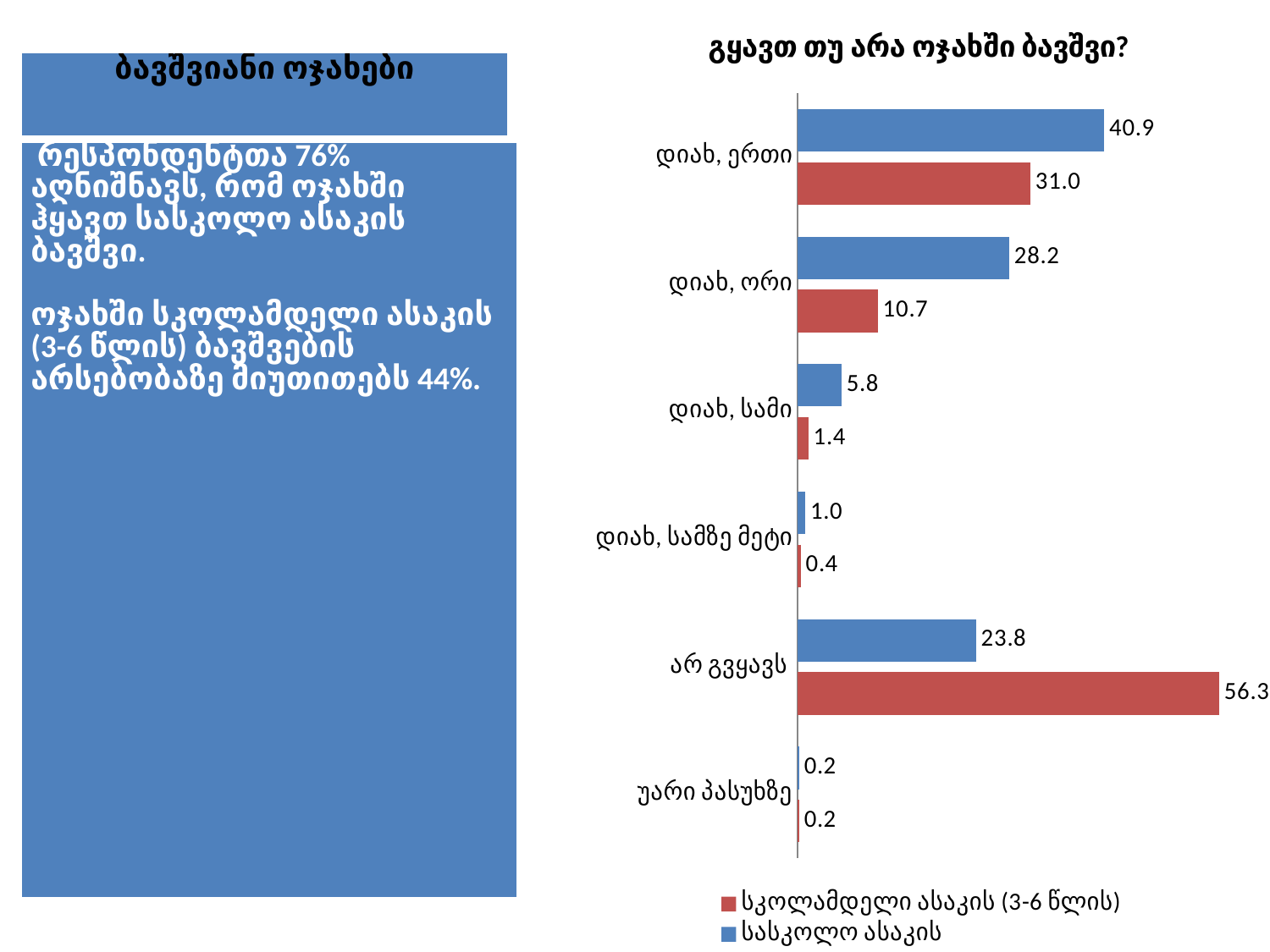
How many categories are shown on the chart? 6 What kind of chart is shown on the slide? bar chart What is the difference between the სასკოლო ასაკის and სკოლამდელი ასაკის (3-6 წლის) values in the category დიახ, ერთი? 9.9 How many series does the legend list? 2 What is the value for სკოლამდელი ასაკის (3-6 წლის) in the category დიახ, ორი? 10.7 What is the value for სკოლამდელი ასაკის (3-6 წლის) in the category არ გვყავს? 56.3 Which category has the highest value for the სასკოლო ასაკის series? დიახ, ერთი In the category არ გვყავს, which series has the larger value: სასკოლო ასაკის or სკოლამდელი ასაკის (3-6 წლის)? სკოლამდელი ასაკის (3-6 წლის) What is the title of the chart? გყავთ თუ არა ოჯახში ბავშვი? Which category has the lowest value for the სასკოლო ასაკის series? უარი პასუხზე What is the value for სასკოლო ასაკის in the category დიახ, ერთი? 40.9 Which category has the highest value for the სკოლამდელი ასაკის (3-6 წლის) series? არ გვყავს